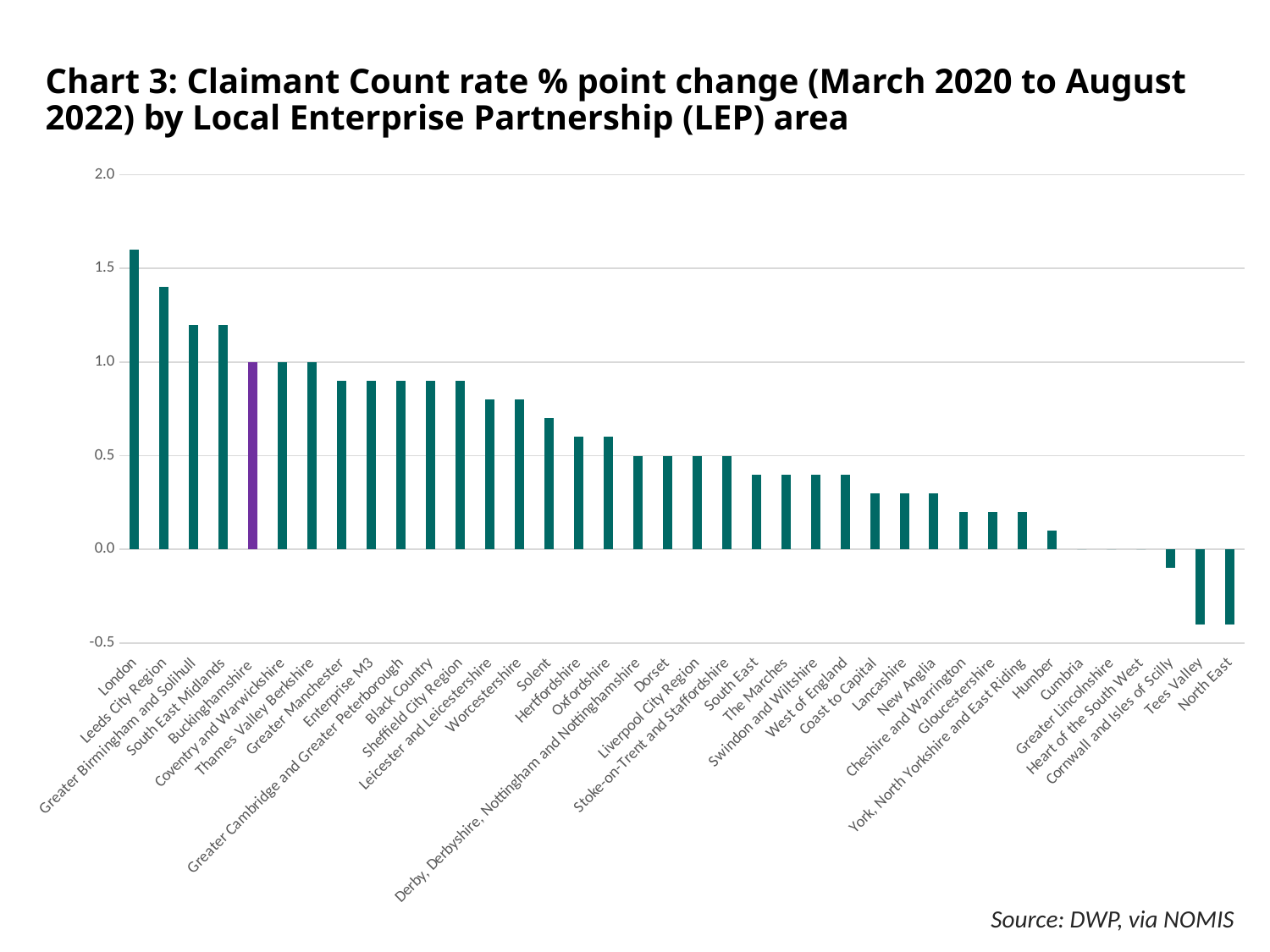
Which has the larger value, Solent or Humber? Solent Do the values generally rise or fall moving from left to right along the x axis? Fall How many LEP areas are listed on the x axis? 38 Is the value for Greater Manchester greater or less than 1.0? less Which LEP area's bar is coloured purple rather than green? Buckinghamshire What is the Claimant Count rate % point change for Dorset? 0.5 Which has the larger value, Leeds City Region or South East Midlands? Leeds City Region Is the value for Tees Valley greater or less than 0.0? less What kind of chart is shown on the slide? Bar chart Is the value for London greater or less than 1.5? greater What is the Claimant Count rate % point change for Buckinghamshire? 1.0 Which LEP area has the highest Claimant Count rate % point change? London